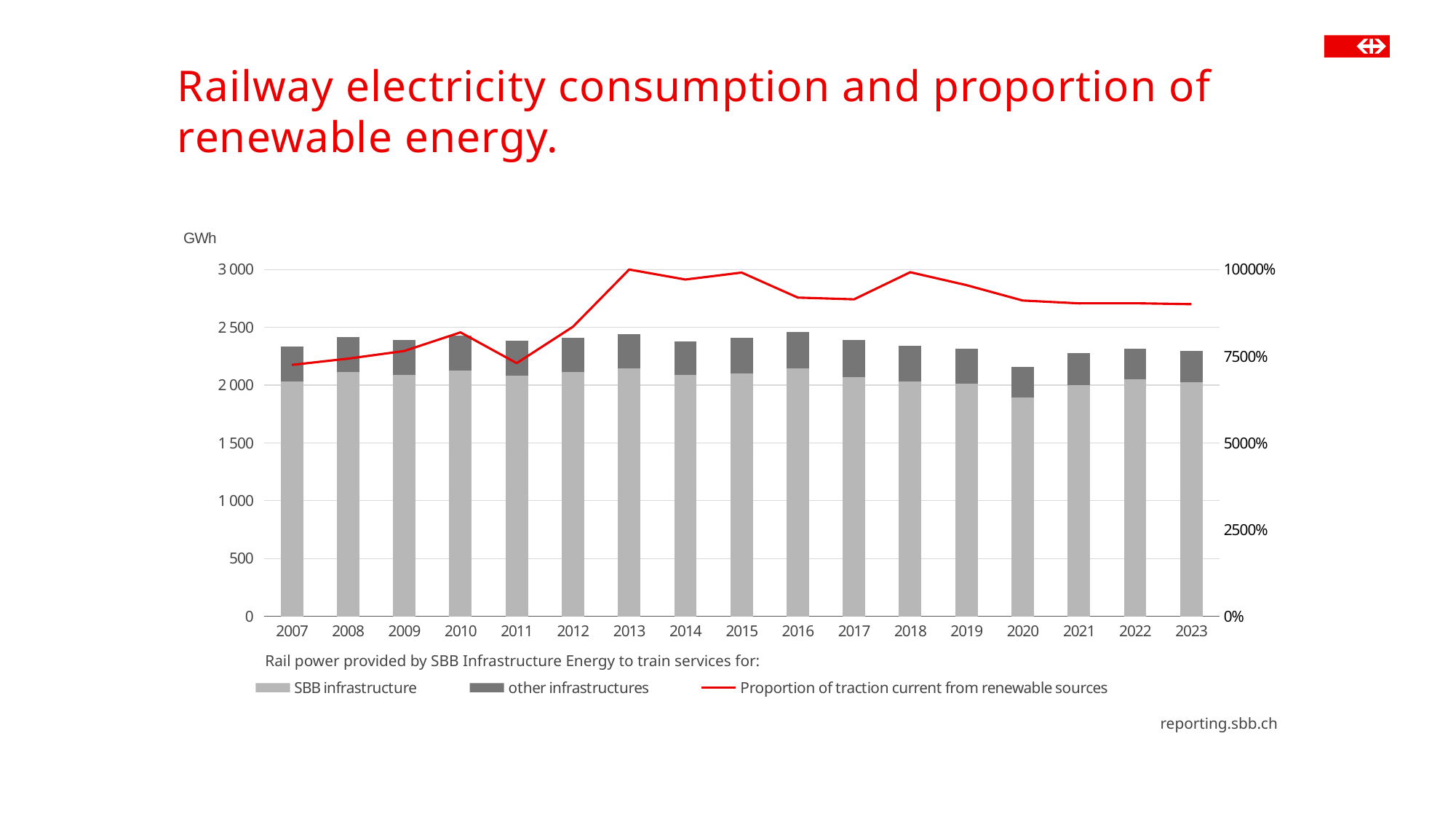
Is the SBB infrastructure value for 2020 greater or less than 2 000 GWh? less How many years are shown on the x axis of the chart? 17 Is the total stacked bar for 2020 greater or less than 2 500 GWh? less Which year has the lowest total stacked bar? 2020 Which year has the higher proportion of traction current from renewable sources, 2011 or 2012? 2012 Is the total stacked bar for 2016 greater or less than 2 000 GWh? greater What unit is shown on the left vertical axis of the chart? GWh Does the proportion of traction current from renewable sources rise or fall from 2007 to 2013? rise How many series does the chart legend list? 3 What kind of chart is shown on the slide? A stacked bar chart with a line overlay